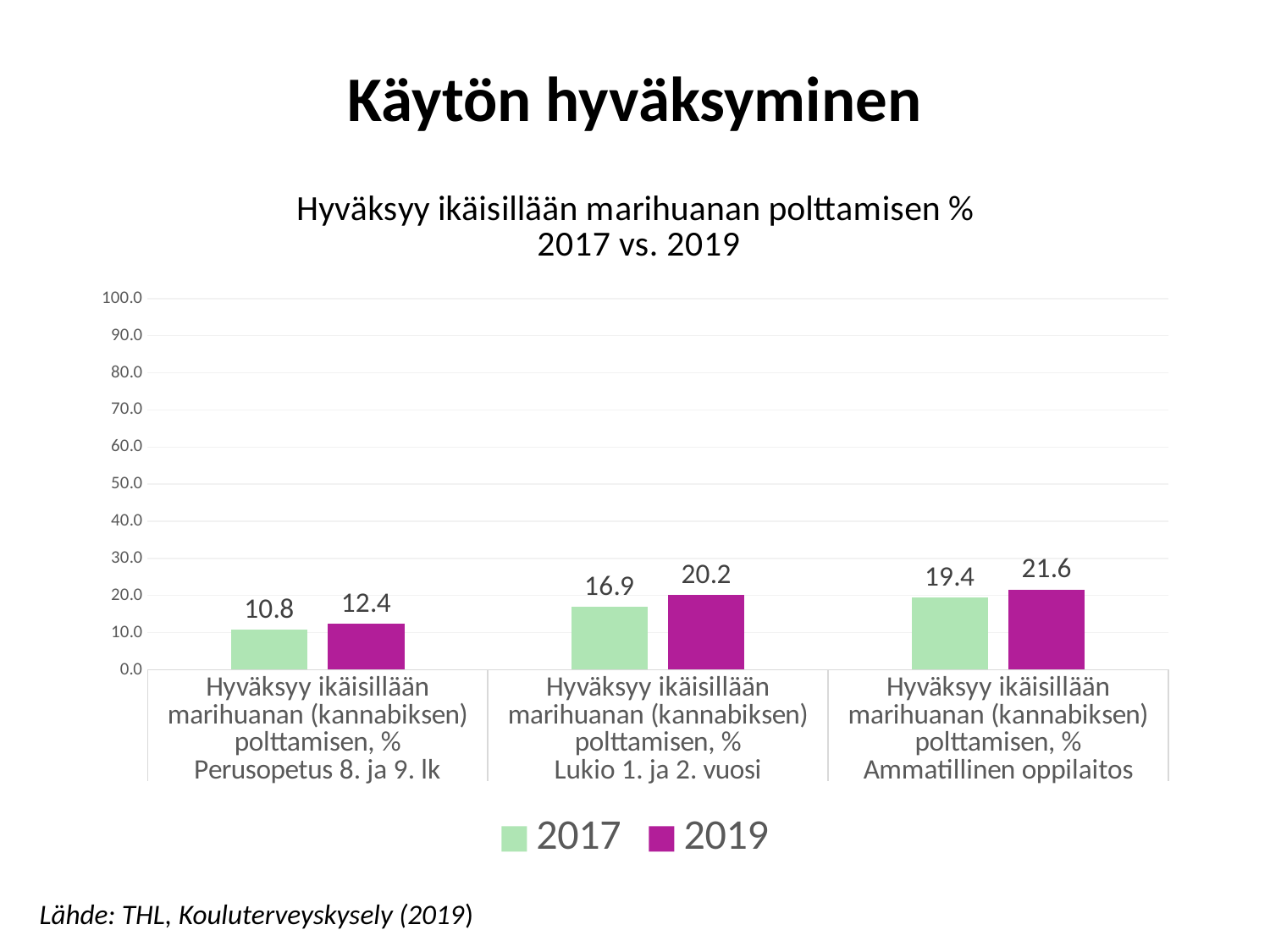
Which category has the lowest 2017 value? Perusopetus 8. ja 9. lk What kind of chart is shown on the slide? bar chart What is the difference between the 2019 and 2017 values for Perusopetus 8. ja 9. lk? 1.6 What is the 2017 value for Perusopetus 8. ja 9. lk? 10.8 What is the difference between the 2019 values for Ammatillinen oppilaitos and Lukio 1. ja 2. vuosi? 1.4 Is the 2019 value for Ammatillinen oppilaitos greater or less than 20.0? greater How many series does the legend list? 2 What is the 2019 value for Ammatillinen oppilaitos? 21.6 Which is larger: the 2017 value for Lukio 1. ja 2. vuosi or the 2017 value for Ammatillinen oppilaitos? Ammatillinen oppilaitos How many categories are shown on the x axis? 3 What is the 2019 value for Lukio 1. ja 2. vuosi? 20.2 Which category has the highest 2019 value? Ammatillinen oppilaitos